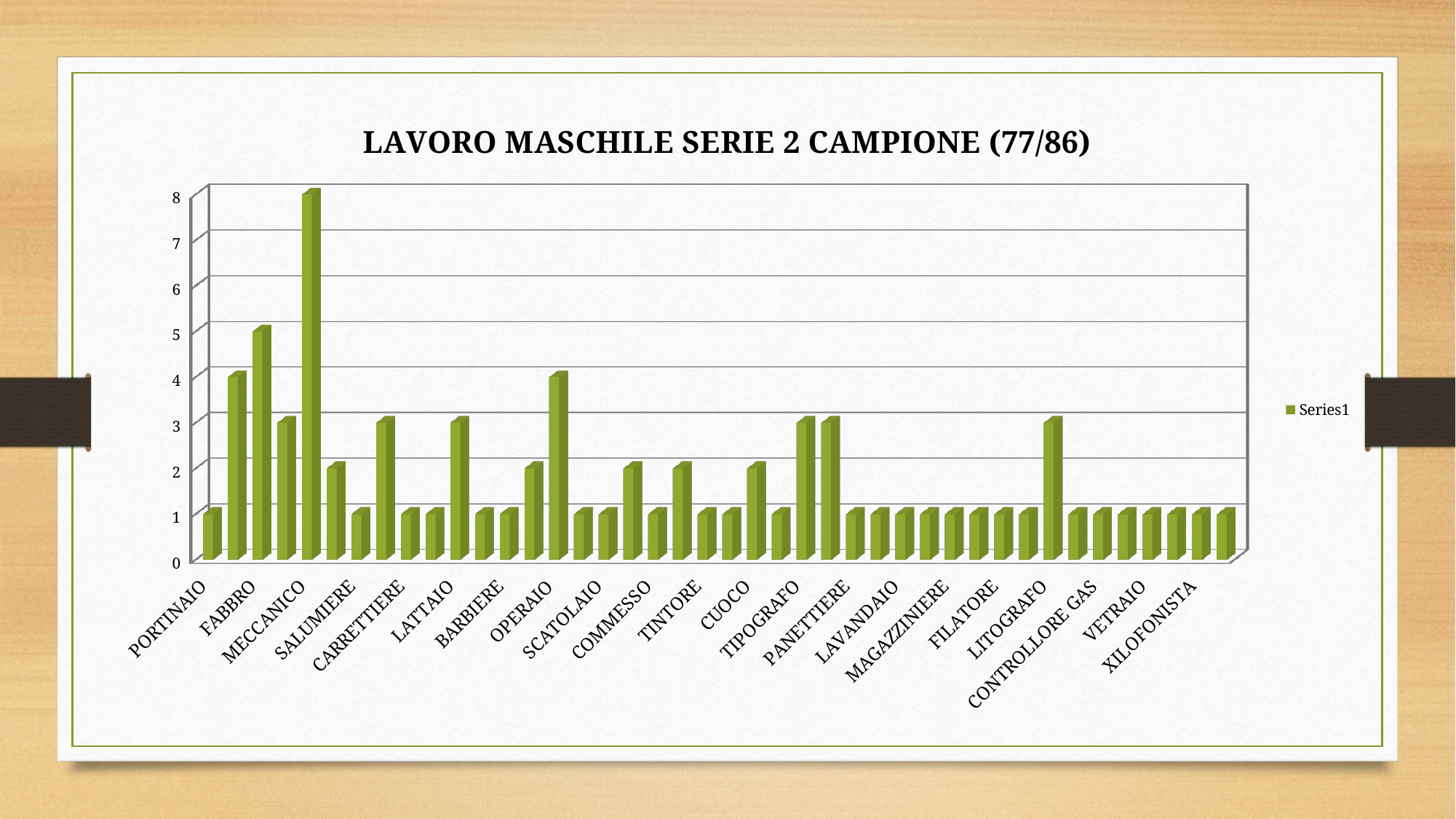
What is the value for OPERAIO? 4 Which category has the highest value? MECCANICO Is the value for MECCANICO greater or less than 6? greater What is the value for MECCANICO? 8 What is the value for FABBRO? 5 How many series does the legend list? 1 What kind of chart is shown on the slide? bar chart What is the difference between the values for MECCANICO and FABBRO? 3 What is the name of the series shown in the legend? Series1 Which is larger, the value for FABBRO or the value for OPERAIO? FABBRO What is the value for PORTINAIO? 1 What is the title of the chart? LAVORO MASCHILE SERIE 2 CAMPIONE (77/86)